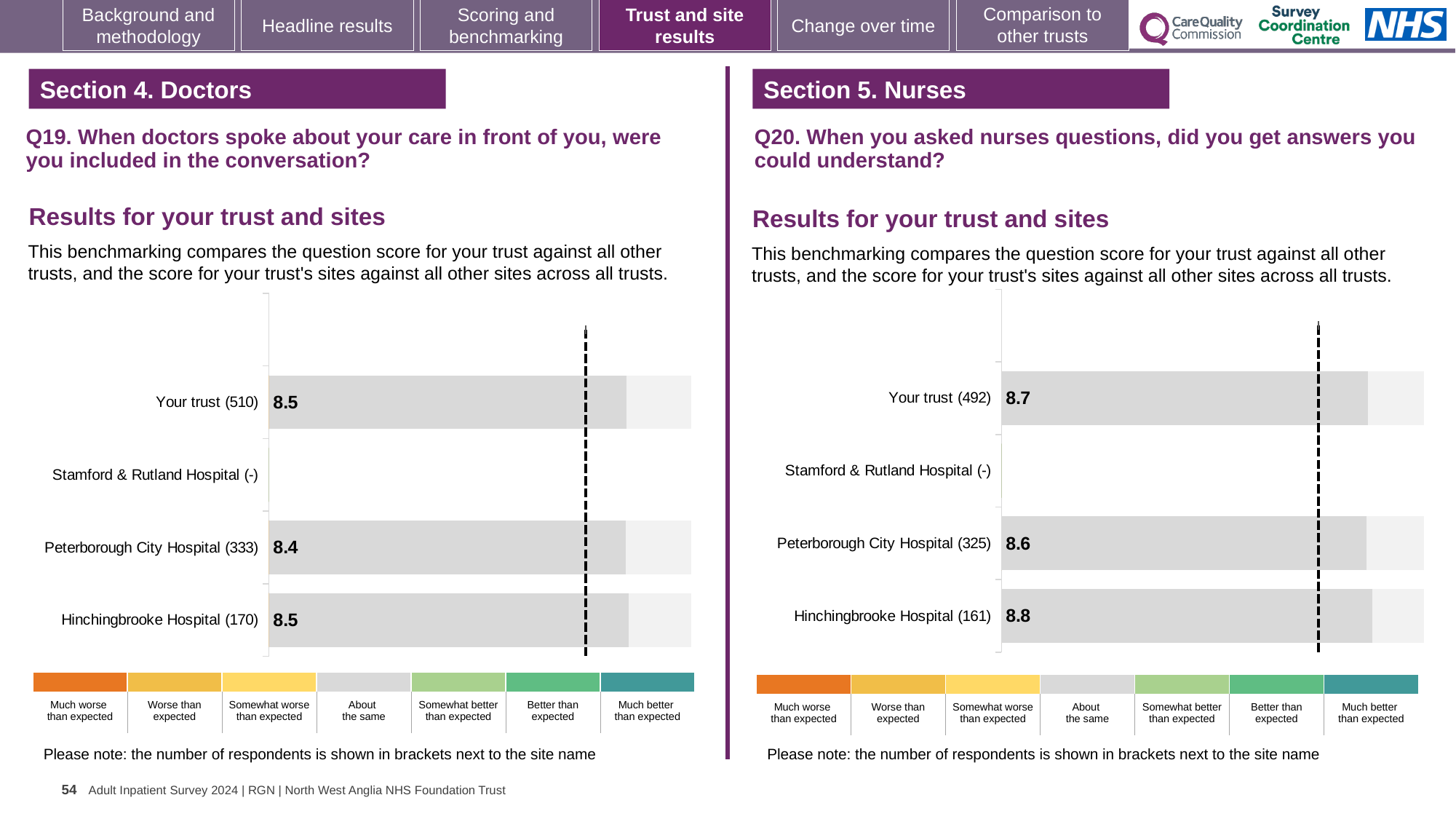
In the Q19 chart on the left, what is the score for Hinchingbrooke Hospital? 8.5 In the Q20 chart on the right, what is the score for Peterborough City Hospital? 8.6 In the Q19 chart on the left, how many respondents are shown in brackets for Hinchingbrooke Hospital? 170 In the Q20 chart on the right, which site or trust has the lowest score shown? Peterborough City Hospital In the Q20 chart on the right, what is the difference between the scores for Hinchingbrooke Hospital and Peterborough City Hospital? 0.2 In the Q19 chart on the left, what is the score for Your trust? 8.5 In the Q20 chart on the right, what is the score for Your trust? 8.7 What kind of chart is used in the Q19 chart on the left? Bar chart In the Q20 chart on the right, what is the score for Hinchingbrooke Hospital? 8.8 In the Q19 chart on the left, what is the score for Peterborough City Hospital? 8.4 In the Q19 chart on the left, which has the higher score, Your trust or Peterborough City Hospital? Your trust In the Q20 chart on the right, which site or trust has the highest score? Hinchingbrooke Hospital